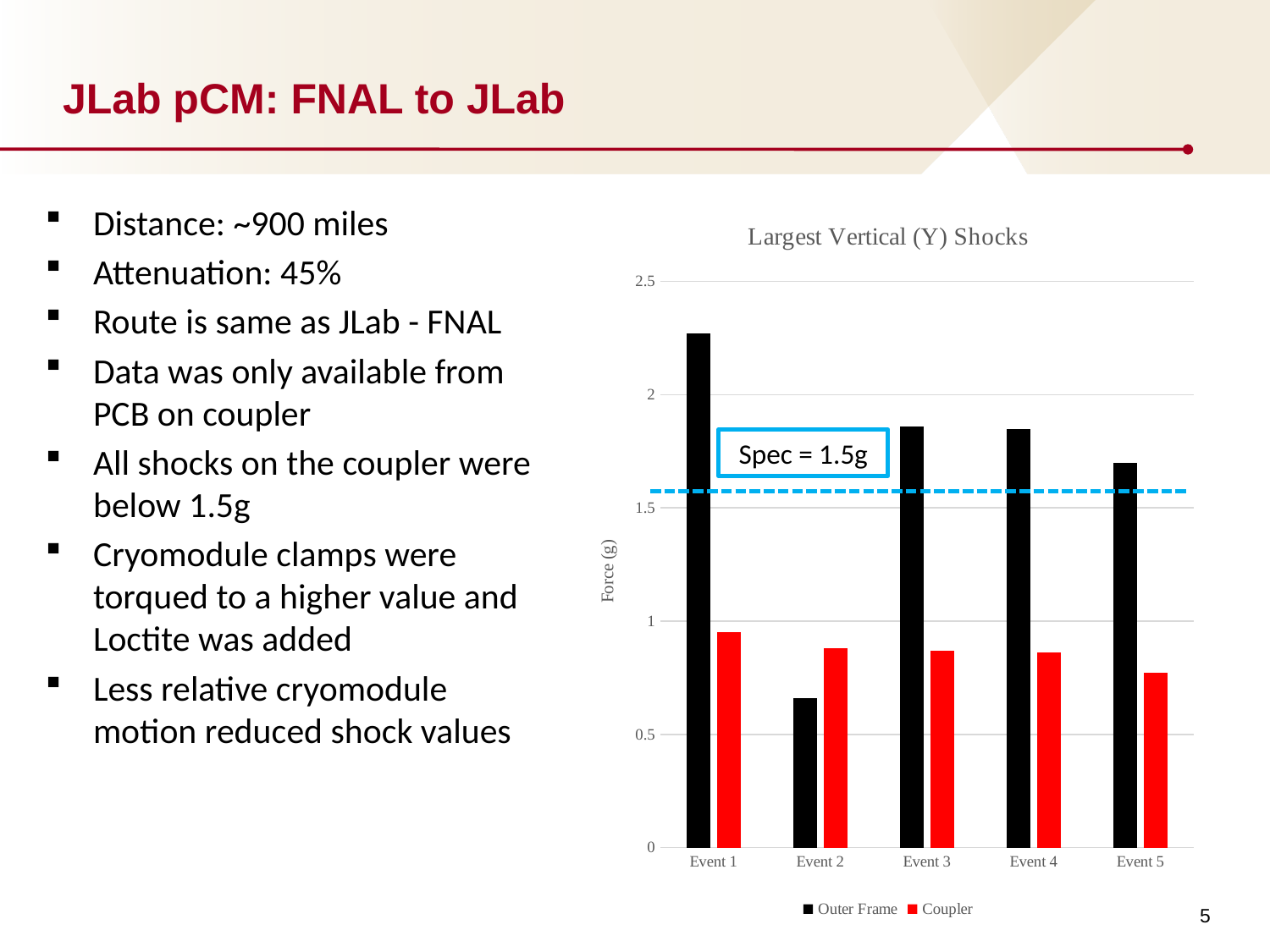
What kind of chart is shown on the slide? Bar chart Is the Coupler value for Event 1 greater or less than 1? less What is the title of the chart? Largest Vertical (Y) Shocks What is the label on the y axis of the chart? Force (g) How many series does the chart legend list? 2 Which event has the highest Outer Frame value? Event 1 How many events are plotted on the x axis of the chart? 5 For Event 2, which is larger, the Outer Frame value or the Coupler value? Coupler Which event has the lowest Coupler value? Event 5 Which event has the lowest Outer Frame value? Event 2 Is the Outer Frame value for Event 1 greater or less than 2? greater Is the Outer Frame value for Event 5 greater or less than 1.5? greater